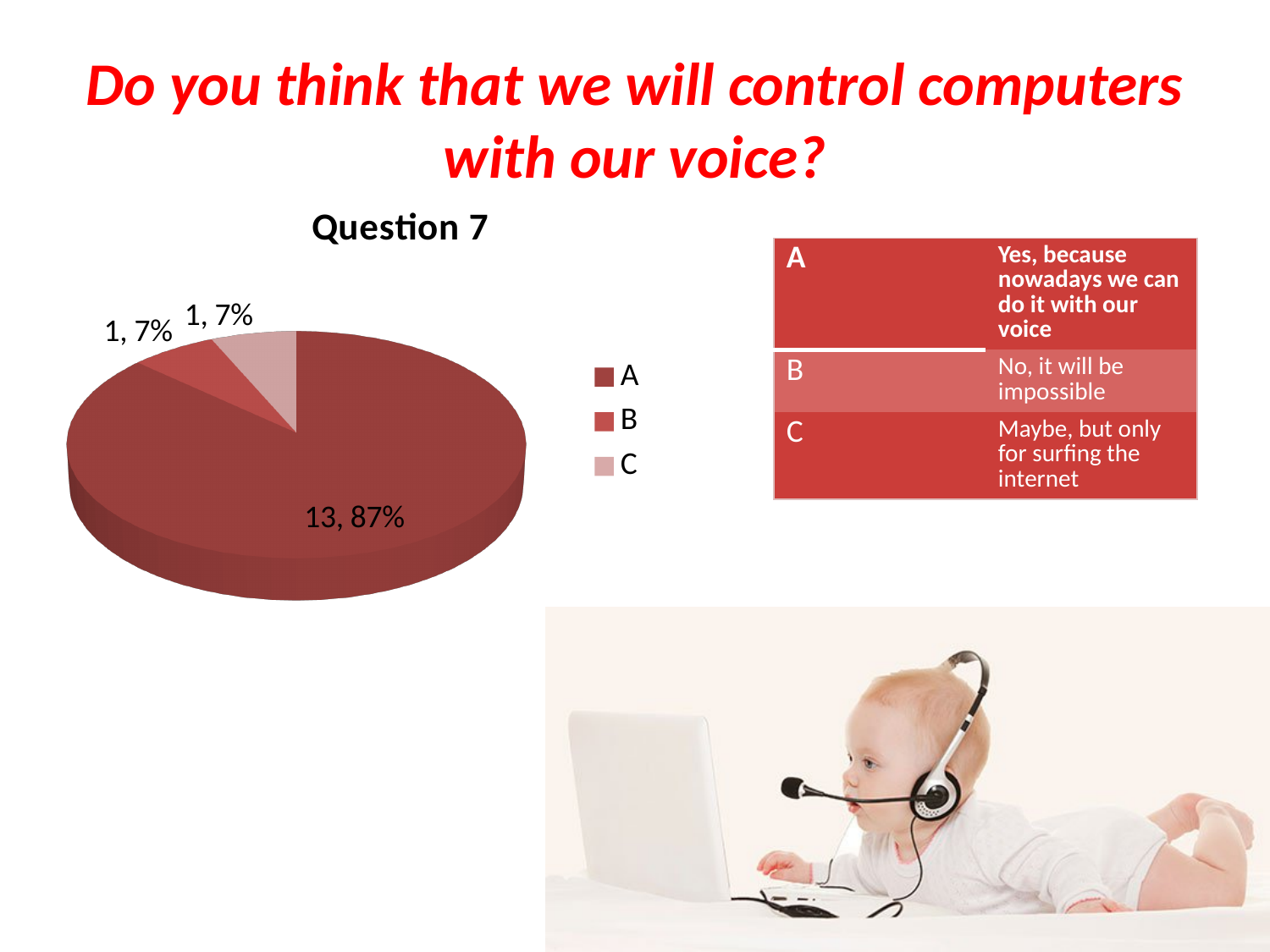
What type of chart is shown under the title "Question 7"? pie chart What is the difference in count between slice A and slice B? 12 What are the legend entries of the chart, in order? A, B, C Which is larger, the slice for A or the slice for C? A What is the count and percentage shown for slice A? 13, 87% How many slices does the pie chart have? 3 What is the title of the chart? Question 7 Which answer option has the largest slice of the pie? A What share of the pie does slice A represent? 87% What is the count and percentage shown for slice C? 1, 7% How many series does the chart legend list? 3 What is the count and percentage shown for slice B? 1, 7%